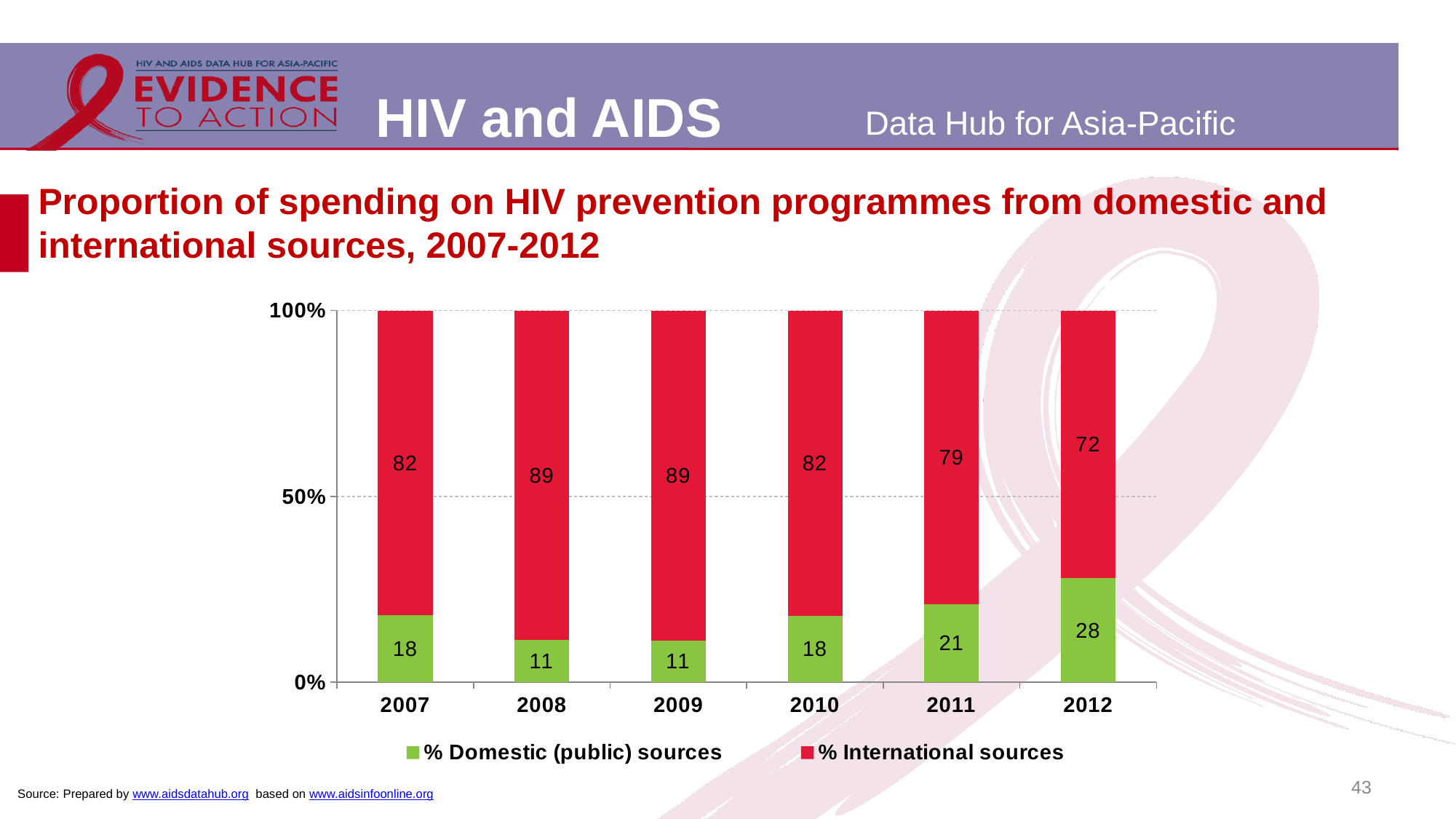
How many series does the legend list? 2 What is the value for % International sources in 2008? 89 Which year has the lowest value for % International sources? 2012 Which is larger, the % Domestic (public) sources value for 2011 or for 2008? 2011 What is the value for % Domestic (public) sources in 2010? 18 How many years are shown on the x axis? 6 What kind of chart is shown on the slide? Stacked bar chart What is the difference between the % International sources values for 2009 and 2012? 17 Which year has the highest value for % Domestic (public) sources? 2012 Does the % Domestic (public) sources value rise or fall from 2009 to 2012? Rise Is the value for % International sources in 2012 greater or less than 50%? greater What is the value for % Domestic (public) sources in 2012? 28